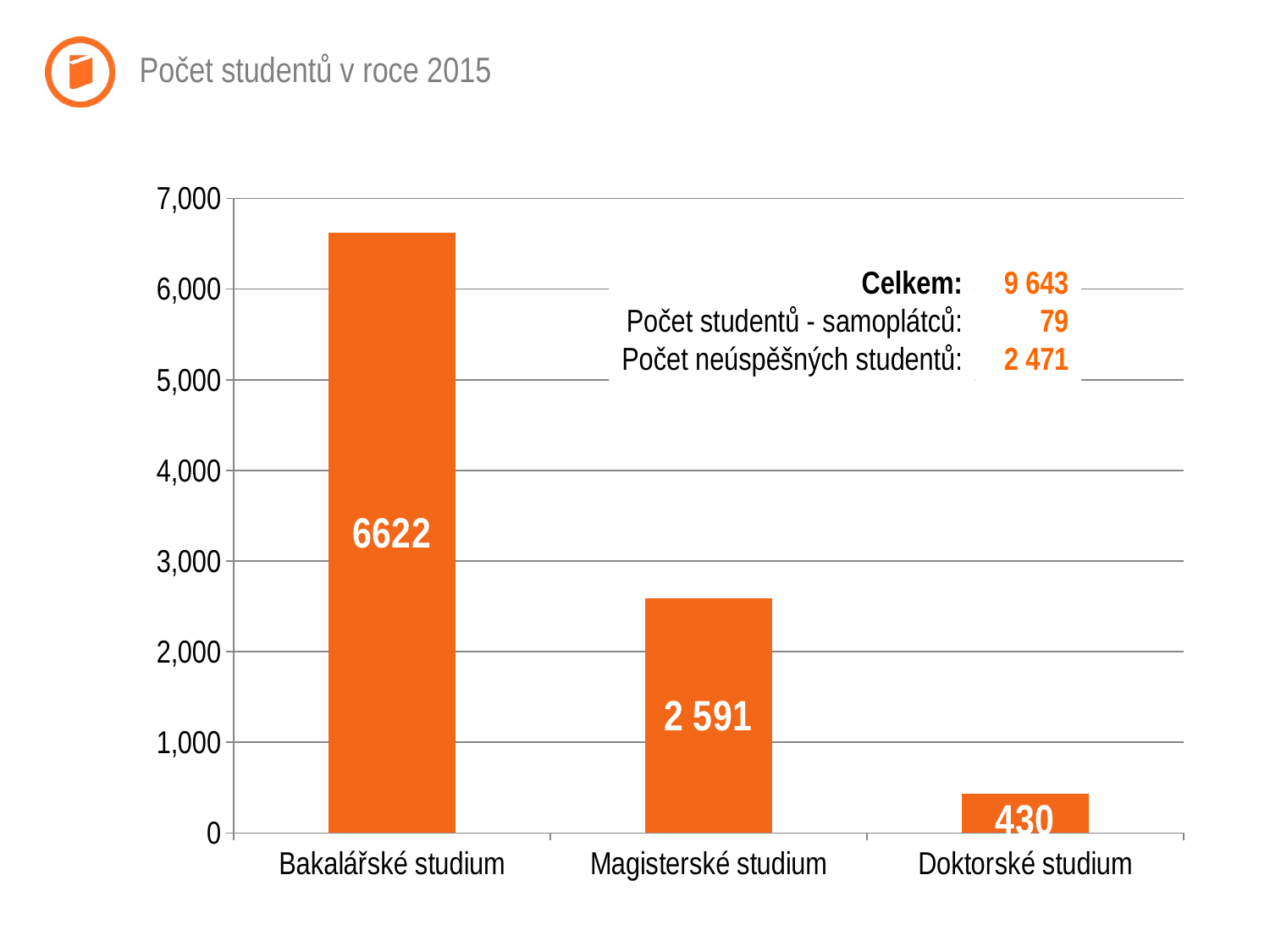
What is the value for Bakalářské studium? 6622 Which category has the highest value? Bakalářské studium Do the values rise or fall from left to right along the x axis? fall What is the value for Doktorské studium? 430 What is the value for Magisterské studium? 2 591 What is the difference between the values for Magisterské studium and Doktorské studium? 2161 Which category has the lowest value? Doktorské studium How many categories are shown on the x axis? 3 What is the difference between the values for Bakalářské studium and Magisterské studium? 4031 Which is larger, the value for Magisterské studium or Doktorské studium? Magisterské studium What kind of chart is shown on the slide? bar chart Is the value for Bakalářské studium greater or less than 6,000? greater